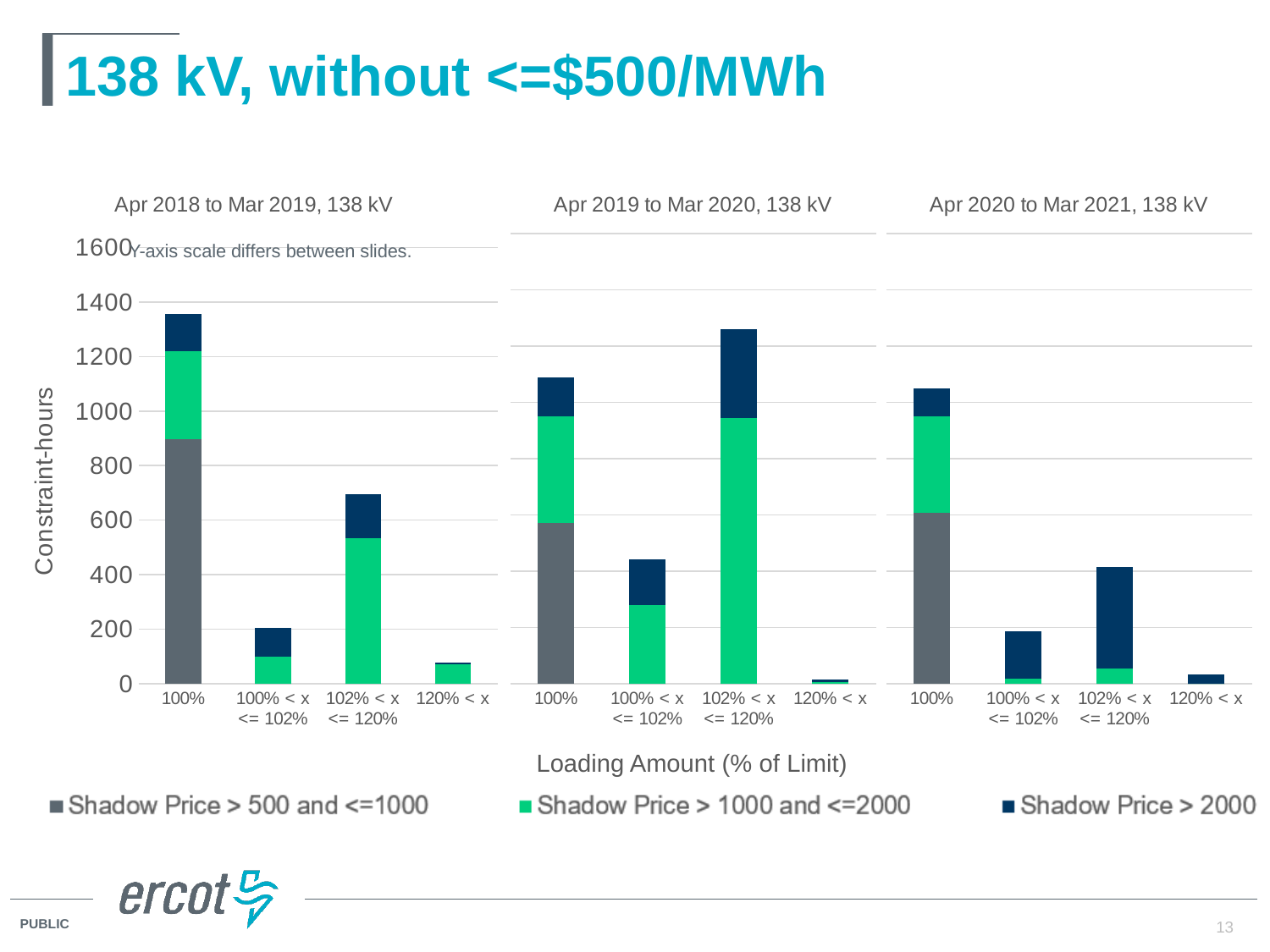
What is the label of the y axis shared by the three charts? Constraint-hours In the 'Apr 2019 to Mar 2020, 138 kV' chart, is the total for the 102% < x <= 120% category greater or less than 1200 constraint-hours? greater In the 'Apr 2018 to Mar 2019, 138 kV' chart, is the total for the 100% category greater or less than 1200 constraint-hours? greater In the 'Apr 2018 to Mar 2019, 138 kV' chart, which loading-amount category has the tallest bar? 100% How many loading-amount categories are shown on the x axis of the 'Apr 2018 to Mar 2019, 138 kV' chart? 4 How many series does the legend list? 3 In the 'Apr 2020 to Mar 2021, 138 kV' chart, which loading-amount category has the shortest bar? 120% < x What kind of chart is used in the three panels on this slide? Stacked bar chart In the 'Apr 2019 to Mar 2020, 138 kV' chart, which loading-amount category has the tallest bar? 102% < x <= 120% In the 'Apr 2020 to Mar 2021, 138 kV' chart, which bar is taller: 100% < x <= 102% or 102% < x <= 120%? 102% < x <= 120% In the 'Apr 2019 to Mar 2020, 138 kV' chart, which bar is taller: 100% or 102% < x <= 120%? 102% < x <= 120% In the 'Apr 2020 to Mar 2021, 138 kV' chart, is the total for the 120% < x category greater or less than 200 constraint-hours? less